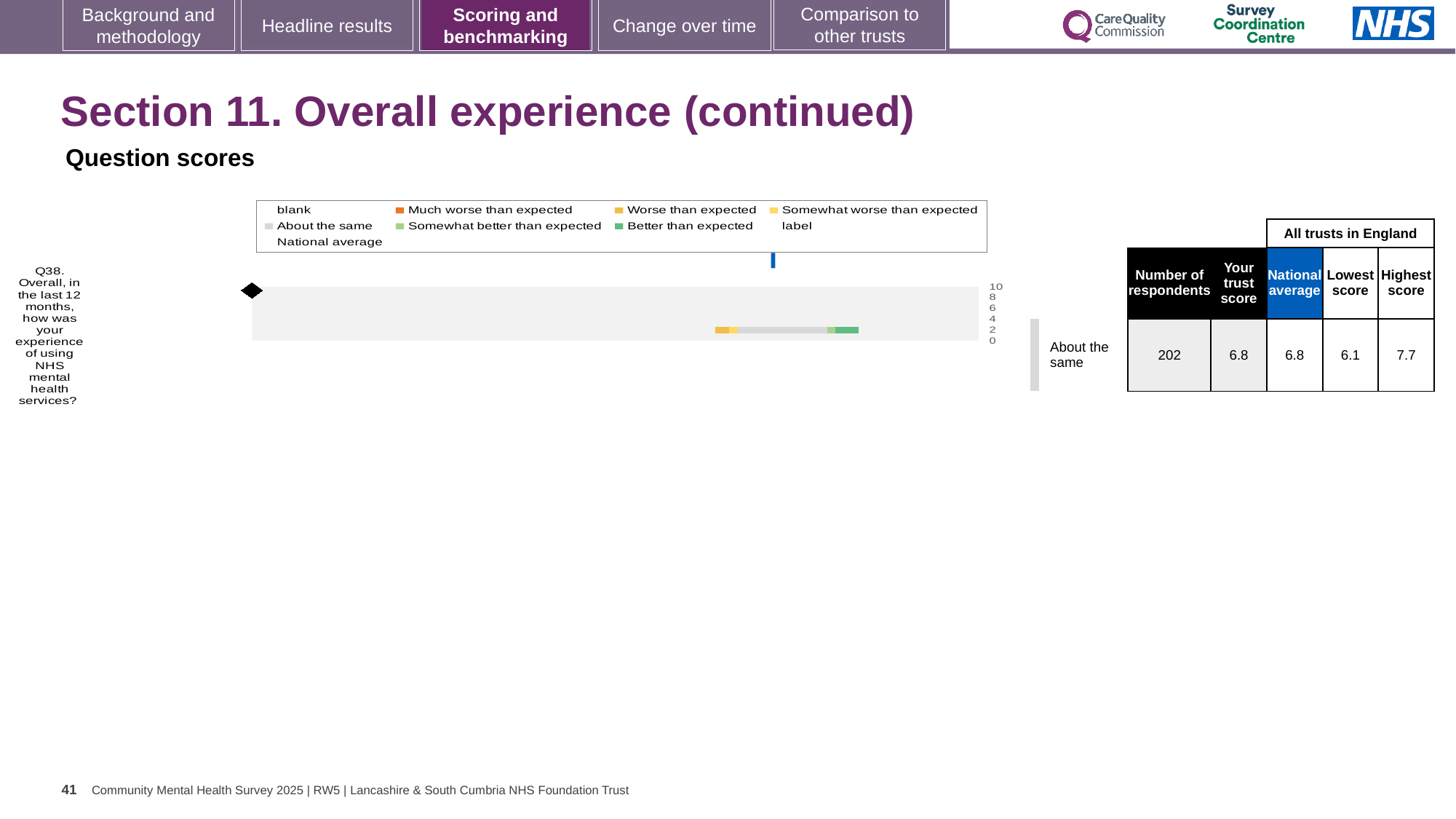
How many respondents answered Q38? 202 How many questions are plotted on the chart on this slide? 1 What is the highest score among all trusts in England shown for Q38? 7.7 Is the trust score for Q38 higher than, lower than, or equal to the national average? equal What benchmarking category is the trust's score for Q38 placed in? About the same What is the national average score shown for Q38? 6.8 What is the difference between the highest score and the lowest score among all trusts in England for Q38? 1.6 What is the maximum value shown on the chart's score axis? 10 What kind of chart is shown on this slide? bar chart What is the lowest score among all trusts in England shown for Q38? 6.1 What is the trust score shown for Q38 (Overall, in the last 12 months, how was your experience of using NHS mental health services?)? 6.8 Which legend entry on the chart is represented by the dark green colour? Better than expected